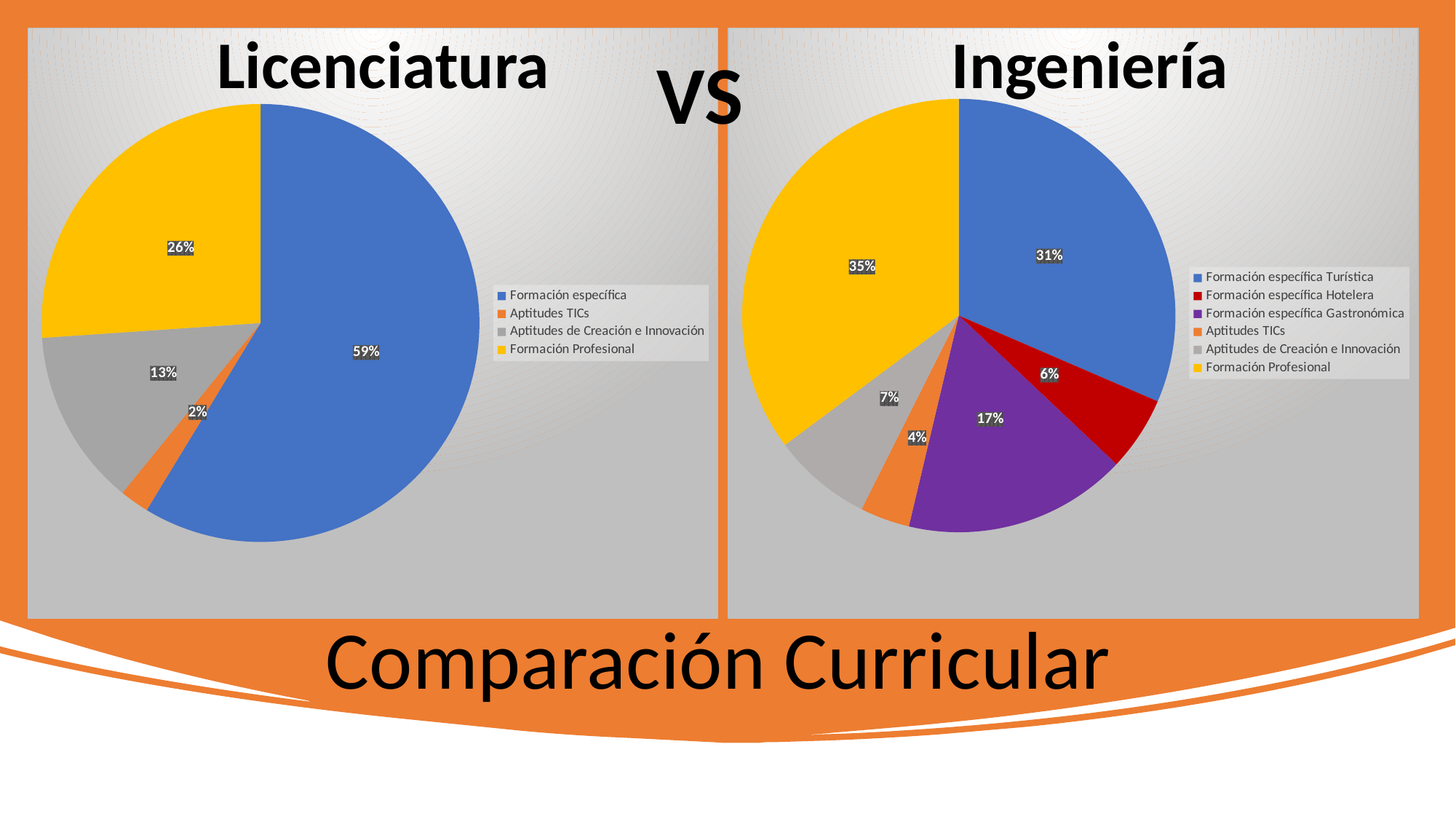
In the Ingeniería pie chart, what is the difference between Formación Profesional and Formación específica Turística? 4% In the Licenciatura pie chart, what percentage is shown for Aptitudes de Creación e Innovación? 13% In the Licenciatura pie chart, what percentage is shown for Formación específica? 59% In the Ingeniería pie chart, which is larger: Formación específica Hotelera or Aptitudes de Creación e Innovación? Aptitudes de Creación e Innovación In the Ingeniería pie chart, what percentage is shown for Formación Profesional? 35% In the Licenciatura pie chart, what is the difference between Formación Profesional and Aptitudes de Creación e Innovación? 13% What type of chart is used for Licenciatura and Ingeniería on this slide? Pie chart In the Ingeniería pie chart, what percentage is shown for Formación específica Gastronómica? 17% In the Ingeniería pie chart, which category has the smallest slice? Aptitudes TICs How many slices does the Licenciatura pie chart have? 4 In the Licenciatura pie chart, which category has the largest slice? Formación específica How many categories does the legend of the Ingeniería pie chart list? 6